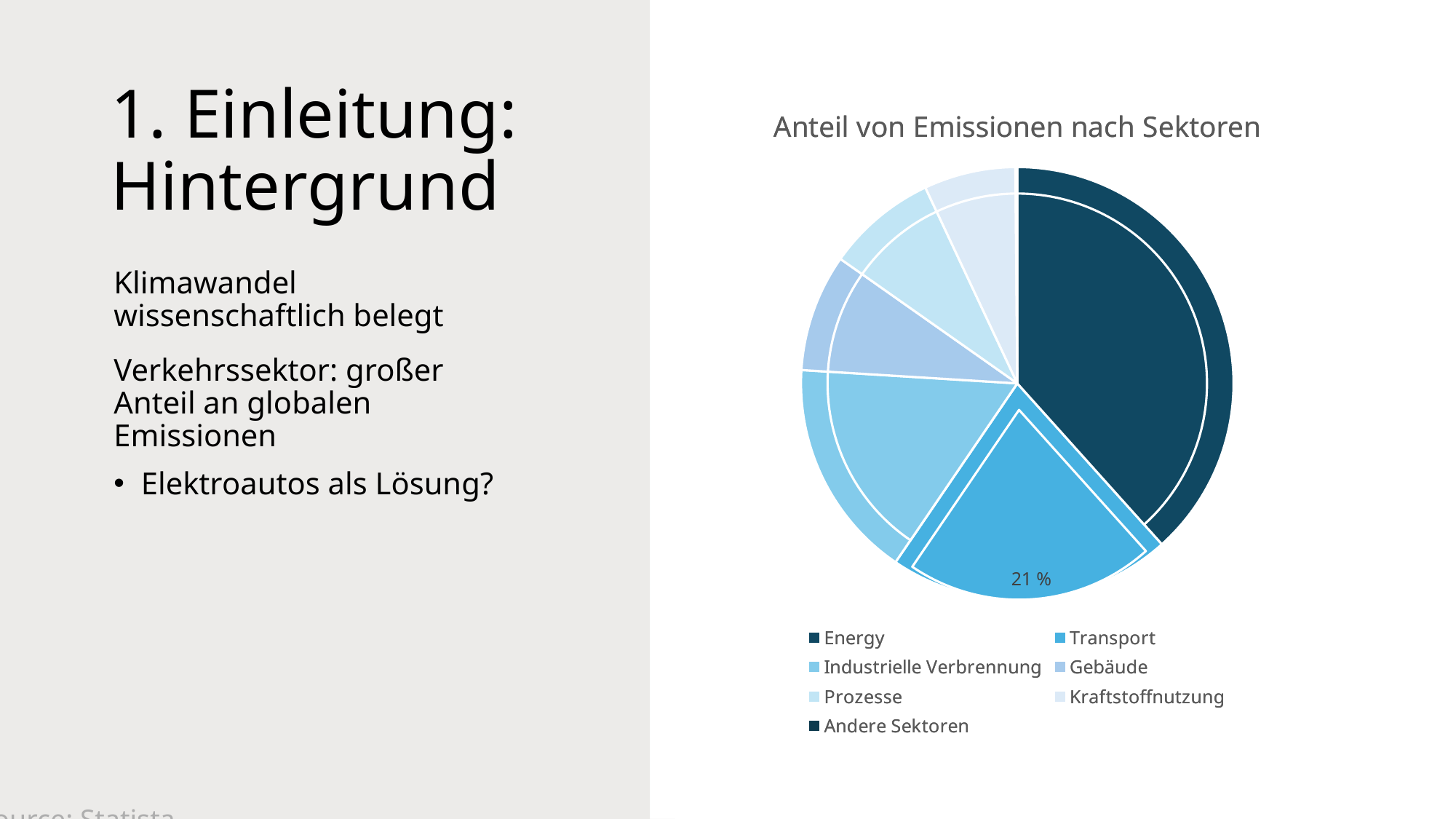
What share of emissions does the Transport slice represent? 21 % What is the title of the chart? Anteil von Emissionen nach Sektoren What kind of chart is shown on the slide? pie chart Which slice is pulled out (exploded) from the pie? Transport Which sector has the largest slice in the pie chart? Energy Which slice is larger, Energy or Transport? Energy Which slice is larger, Transport or Gebäude? Transport Which slice is larger, Industrielle Verbrennung or Prozesse? Industrielle Verbrennung How many entries does the chart legend list? 7